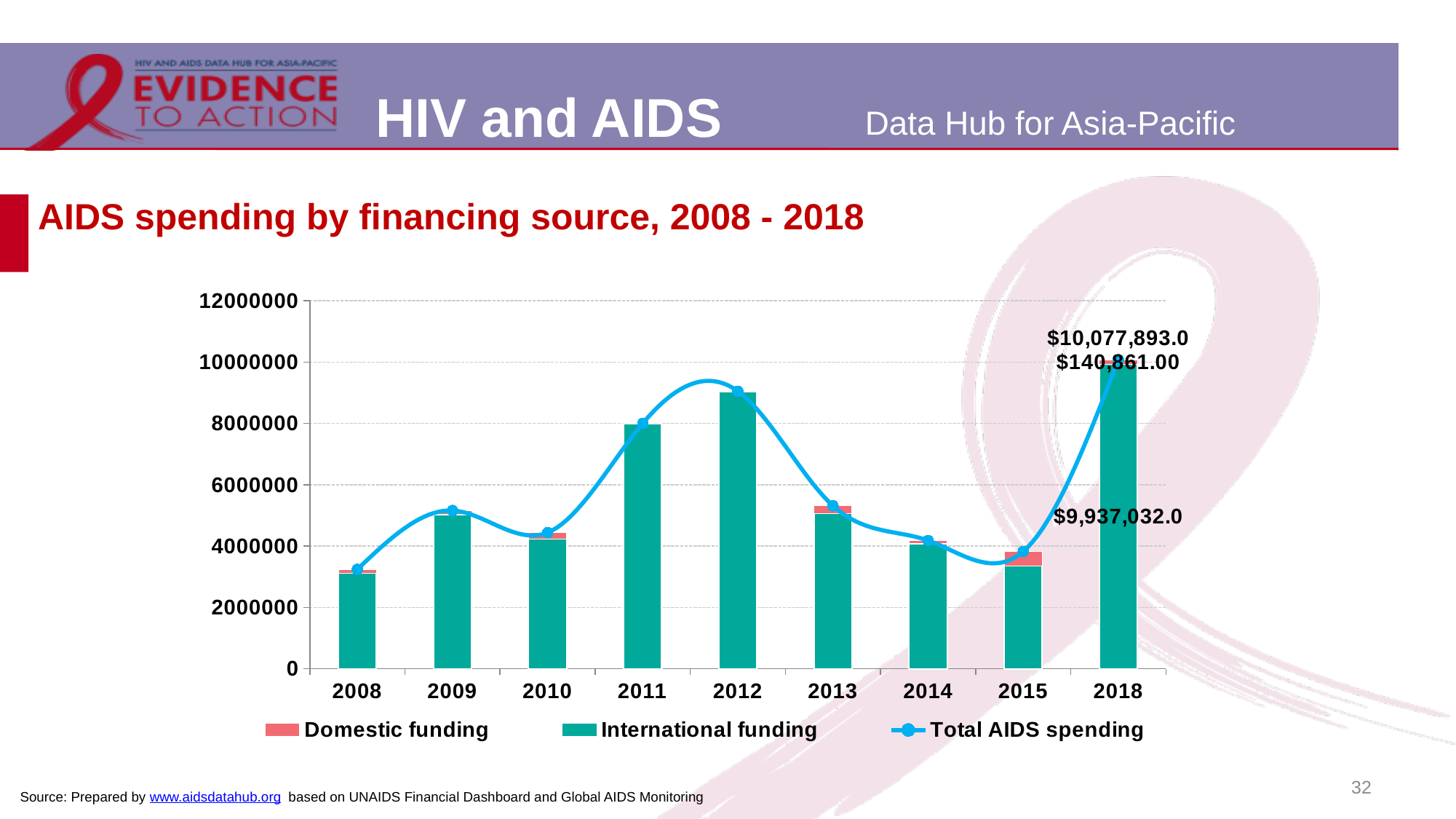
What is the Total AIDS spending value labelled for 2018? $10,077,893.0 How many years are shown on the x axis? 9 What is the International funding value labelled for 2018? $9,937,032.0 Is the Total AIDS spending for 2012 greater or less than 8000000? greater What is the Domestic funding value labelled for 2018? $140,861.00 Which year has the highest Total AIDS spending? 2018 What is the title of the chart? AIDS spending by financing source, 2008 - 2018 How many series does the legend list? 3 Does Total AIDS spending rise or fall from 2012 to 2015? fall Which year has higher Total AIDS spending, 2009 or 2011? 2011 Which year has the lowest Total AIDS spending? 2008 Is the Total AIDS spending for 2010 greater or less than 6000000? less